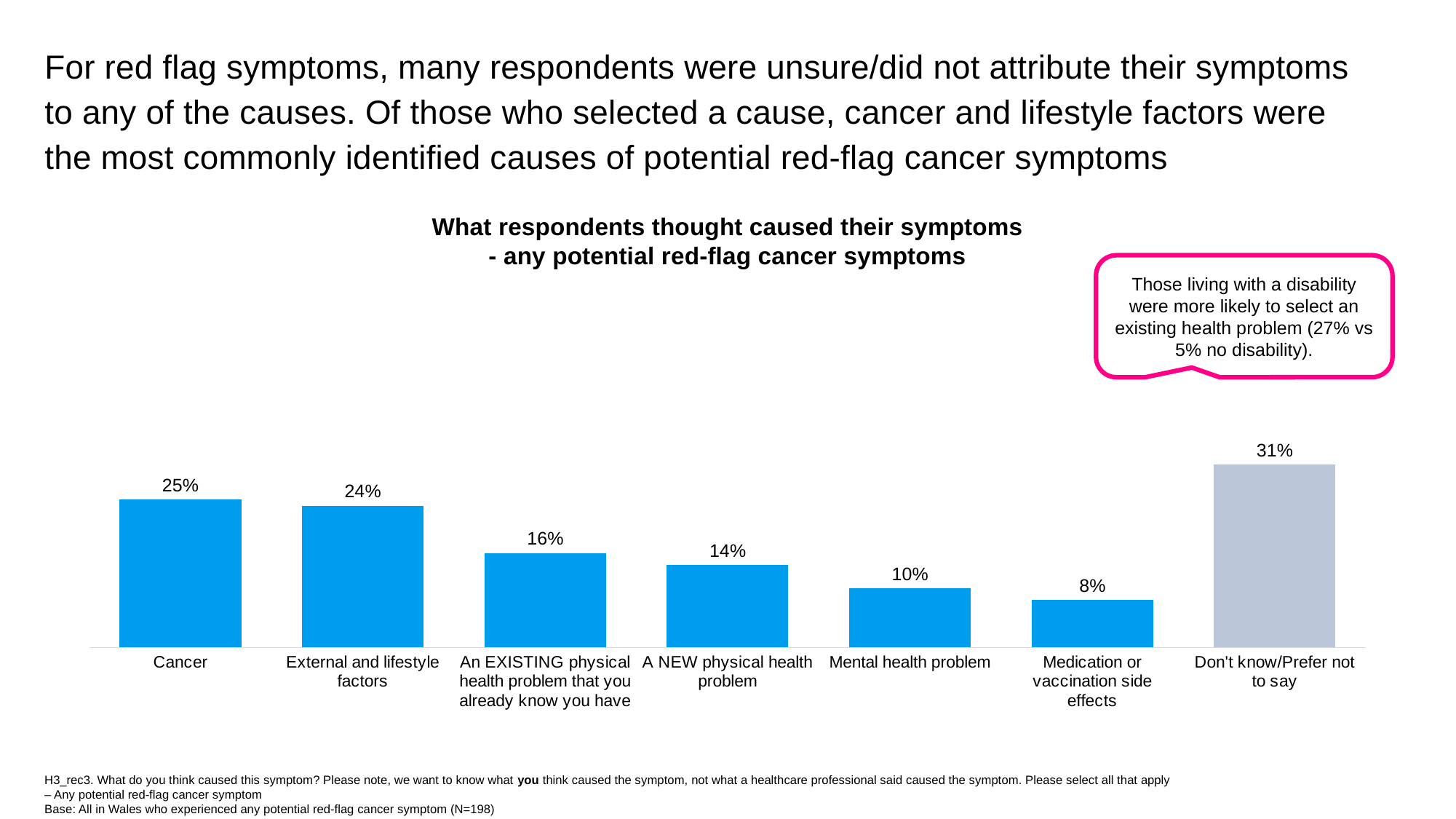
What is the value for 'Mental health problem'? 10% How many categories are shown in the chart? 7 What percentage of respondents thought cancer caused their symptoms? 25% Which is larger: the value for 'An EXISTING physical health problem that you already know you have' or 'Mental health problem'? An EXISTING physical health problem that you already know you have Which category has the highest value? Don't know/Prefer not to say What is the title of the chart? What respondents thought caused their symptoms - any potential red-flag cancer symptoms What is the difference between the values for 'Cancer' and 'A NEW physical health problem'? 11% What is the difference between the values for 'External and lifestyle factors' and 'Medication or vaccination side effects'? 16% What kind of chart is shown on the slide? Bar chart What is the value for 'Don't know/Prefer not to say'? 31% Which category has the lowest value? Medication or vaccination side effects Which bar is shown in a different colour (grey) from the others? Don't know/Prefer not to say